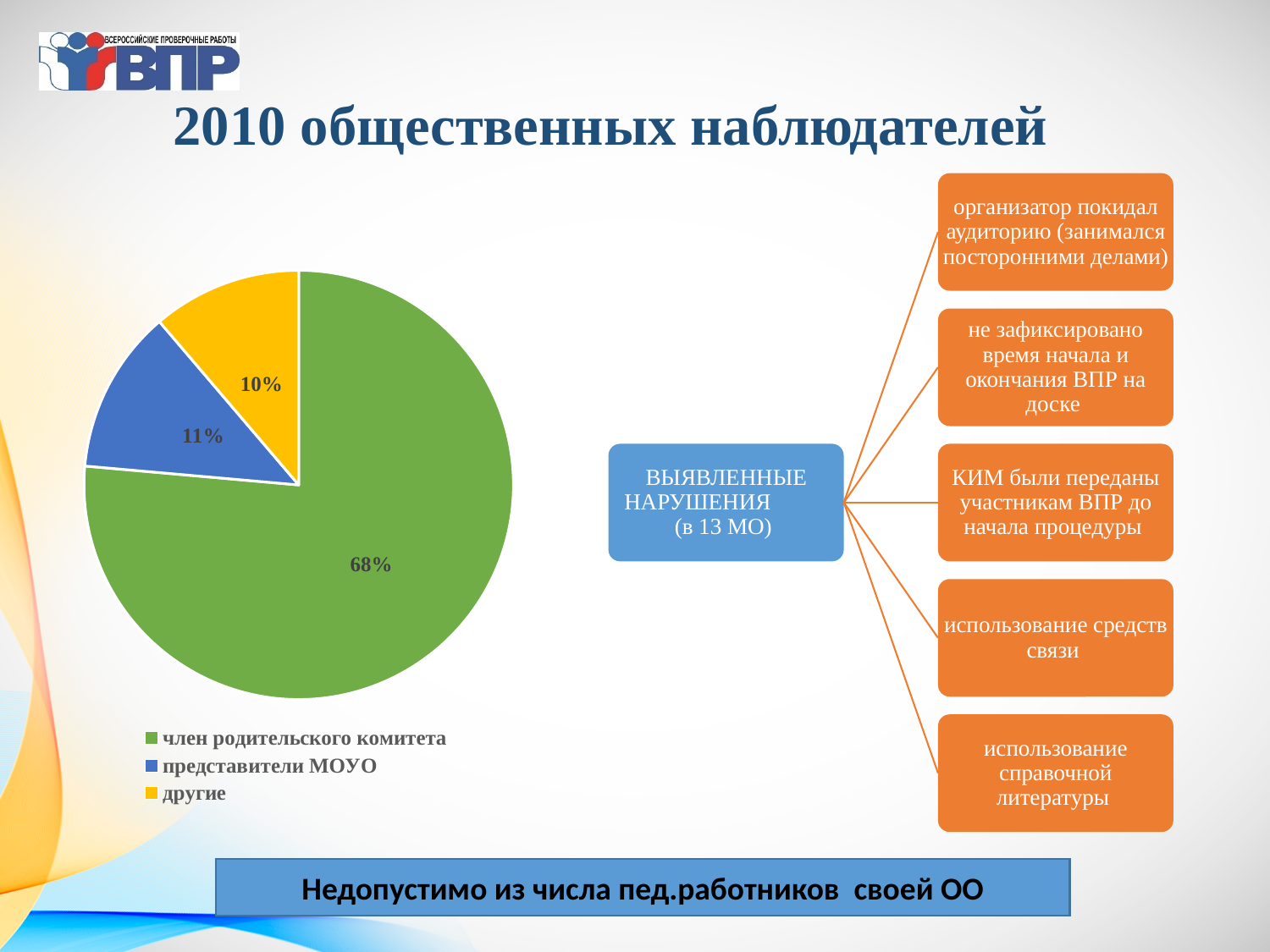
What colour is the slice for "член родительского комитета"? green Which category has the largest slice of the pie? член родительского комитета Which is larger: the slice for "представители МОУО" or the slice for "другие"? представители МОУО How many slices does the pie chart have? 3 What share of the pie is labelled for "другие"? 10% What is the difference in percentage points between "член родительского комитета" and "представители МОУО"? 57 Which category has the smallest slice of the pie? другие How many entries does the legend list? 3 What kind of chart is shown on the slide? pie chart What share of the pie is labelled for "член родительского комитета"? 68% What share of the pie is labelled for "представители МОУО"? 11% What colour is the slice for "другие"? yellow